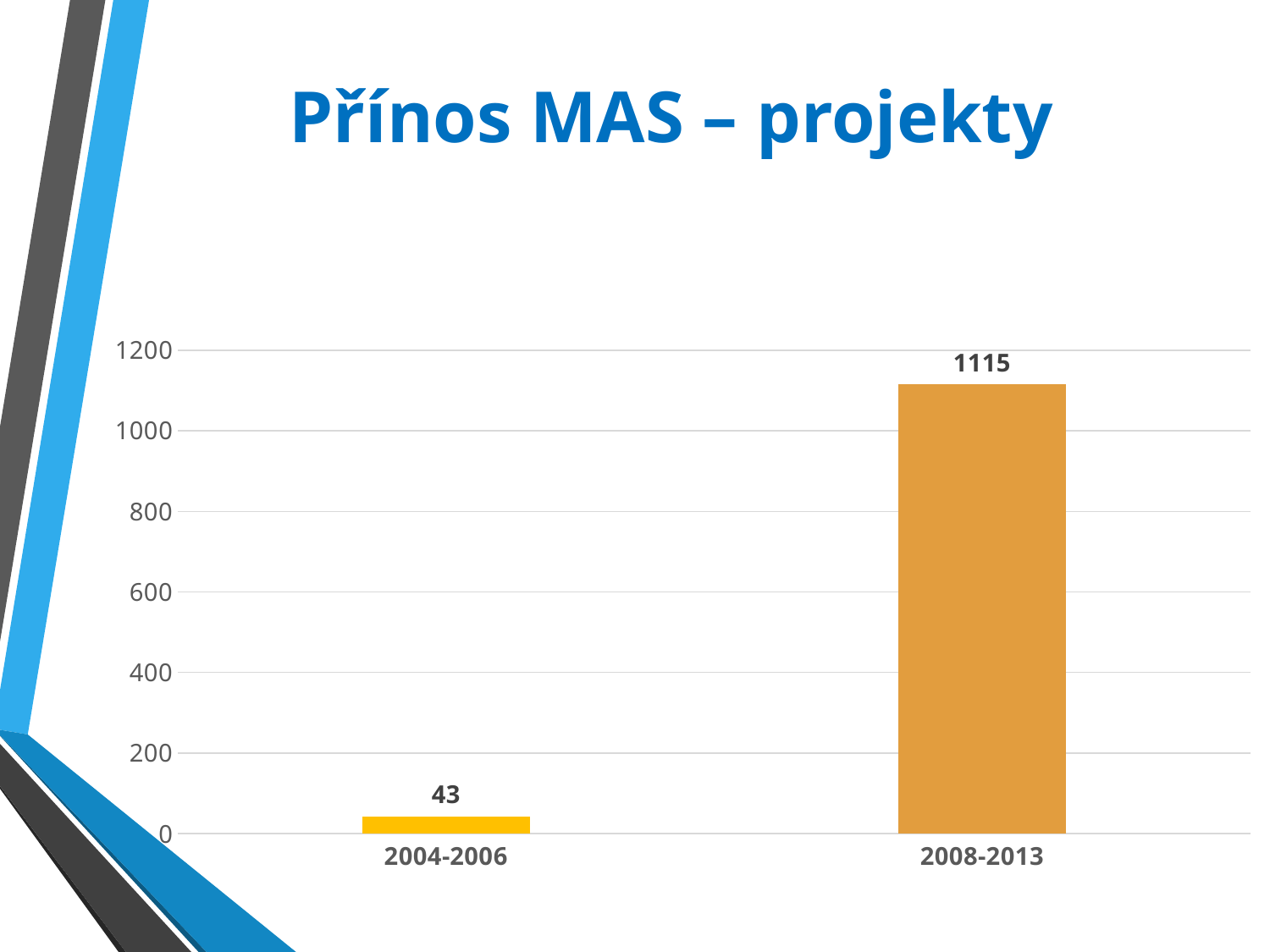
Is the value for 2004-2006 greater or less than 200? less What is the value for 2004-2006? 43 Is the value for 2008-2013 greater or less than 1000? greater Which category has the lowest value? 2004-2006 How many categories are shown on the x axis? 2 Do the values rise or fall from 2004-2006 to 2008-2013? rise What kind of chart is shown on the slide? bar chart What is the value for 2008-2013? 1115 What is the difference between the values for 2008-2013 and 2004-2006? 1072 Which is larger, the value for 2004-2006 or the value for 2008-2013? 2008-2013 What is the title of the slide? Přínos MAS – projekty Which category has the highest value? 2008-2013